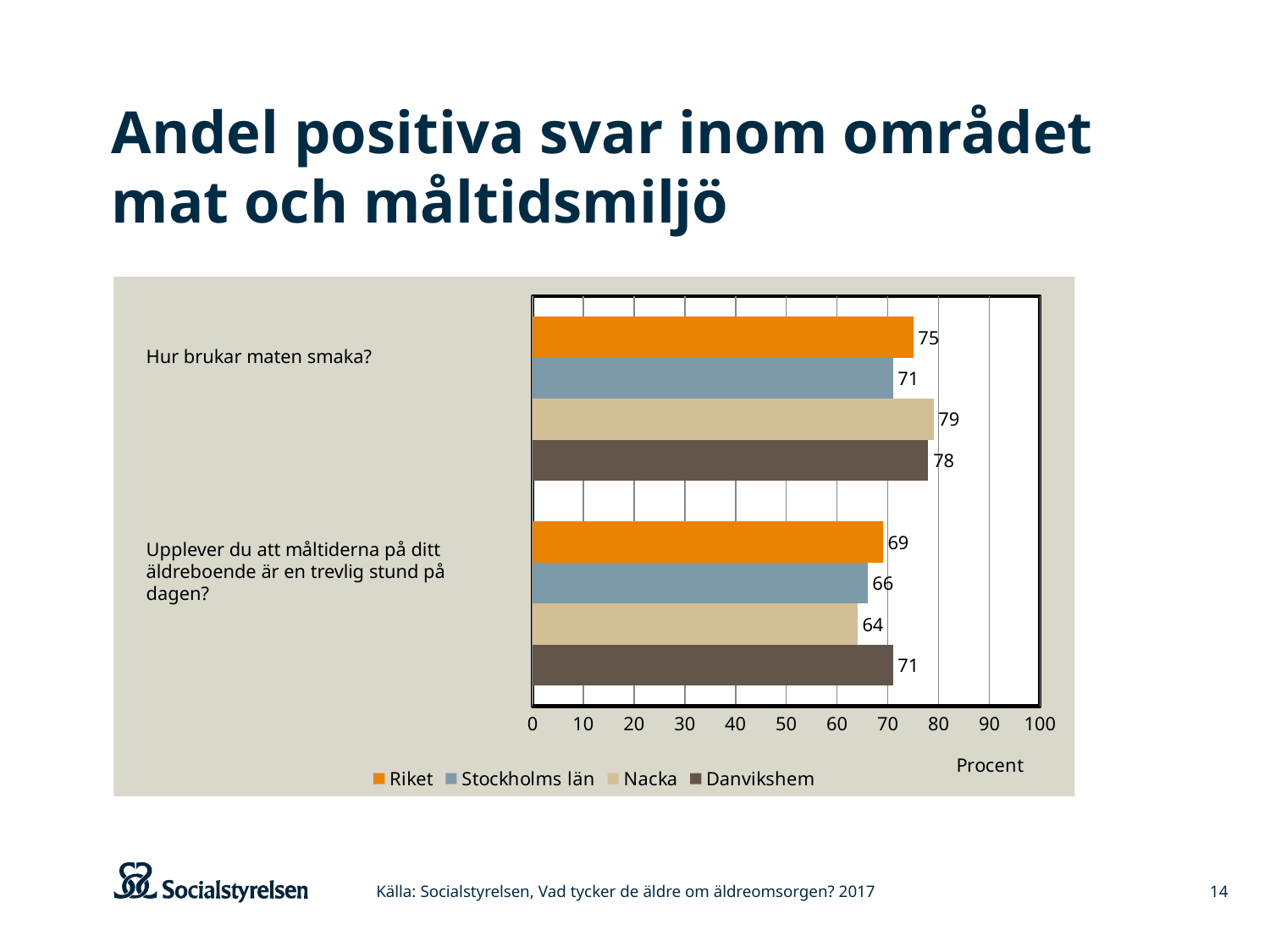
What is the difference between Nacka and Stockholms län for "Hur brukar maten smaka?"? 8 How many questions (categories) are shown on the chart? 2 What value does Riket have for "Upplever du att måltiderna på ditt äldreboende är en trevlig stund på dagen?"? 69 Which series has the lowest value for "Upplever du att måltiderna på ditt äldreboende är en trevlig stund på dagen?"? Nacka Is the value for Stockholms län on "Hur brukar maten smaka?" greater or less than 60? greater How many series does the legend list? 4 What kind of chart is shown on the slide? Bar chart What value does Danvikshem have for "Hur brukar maten smaka?"? 78 Which is larger for "Upplever du att måltiderna på ditt äldreboende är en trevlig stund på dagen?": Danvikshem or Stockholms län? Danvikshem What is the label on the horizontal axis? Procent Which series has the highest value for "Hur brukar maten smaka?"? Nacka What value does Nacka have for "Hur brukar maten smaka?"? 79